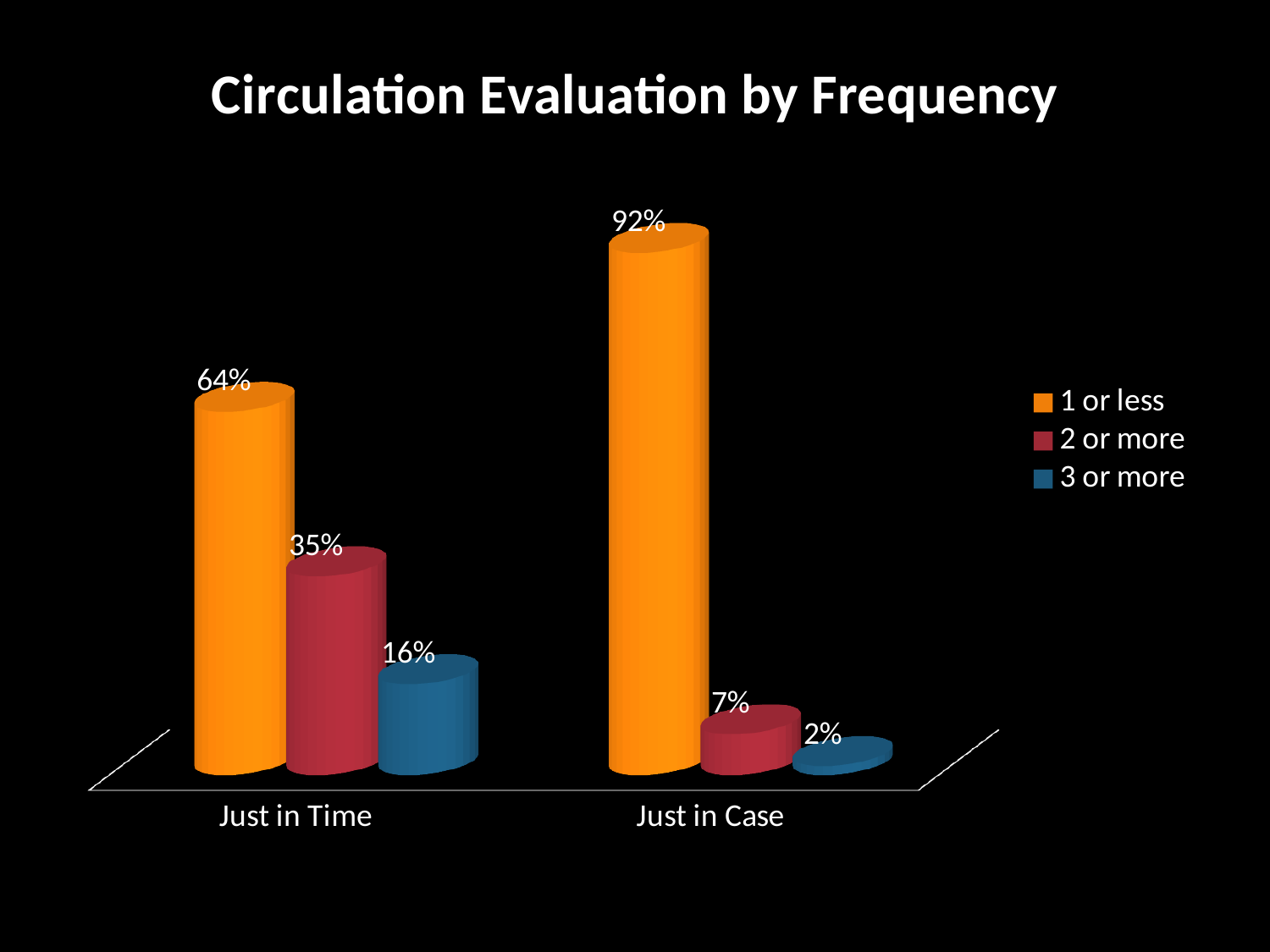
How many categories are shown on the x axis? 2 How many series does the legend list? 3 Which series has the highest value in the 'Just in Case' category? 1 or less Which is larger: '3 or more' for 'Just in Time' or '3 or more' for 'Just in Case'? Just in Time What is the value for '1 or less' in the 'Just in Time' category? 64% What is the value for '3 or more' in the 'Just in Time' category? 16% What is the difference between the '2 or more' values for 'Just in Time' and 'Just in Case'? 28% What is the title of the chart? Circulation Evaluation by Frequency What is the value for '2 or more' in the 'Just in Case' category? 7% Which series has the lowest value in the 'Just in Time' category? 3 or more What is the value for '1 or less' in the 'Just in Case' category? 92% What is the difference between the '1 or less' values for 'Just in Case' and 'Just in Time'? 28%